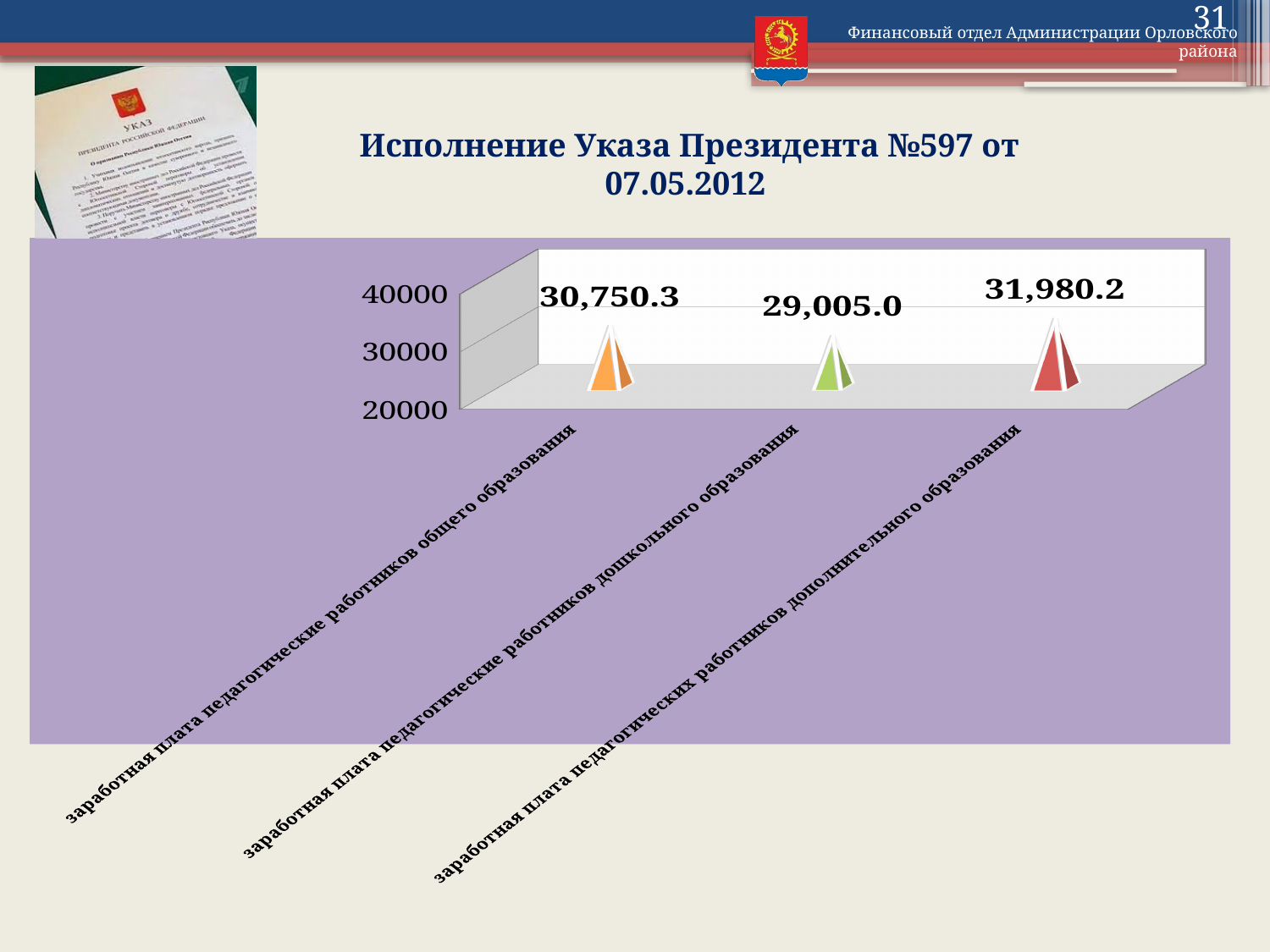
What is the difference between the values for дополнительного образования and дошкольного образования? 2,975.2 What is the title of the slide above the chart? Исполнение Указа Президента №597 от 07.05.2012 What is the value for заработная плата педагогические работников дошкольного образования? 29,005.0 Which category has the highest value? заработная плата педагогических работников дополнительного образования Is the value for заработная плата педагогические работников дошкольного образования greater or less than 30000? less What is the value for заработная плата педагогических работников дополнительного образования? 31,980.2 What is the value for заработная плата педагогические работников общего образования? 30,750.3 How many categories are shown in the chart? 3 Which is larger: the value for общего образования or the value for дополнительного образования? дополнительного образования What kind of chart is shown on the slide? bar chart Which category has the lowest value? заработная плата педагогические работников дошкольного образования What is the difference between the values for общего образования and дошкольного образования? 1,745.3